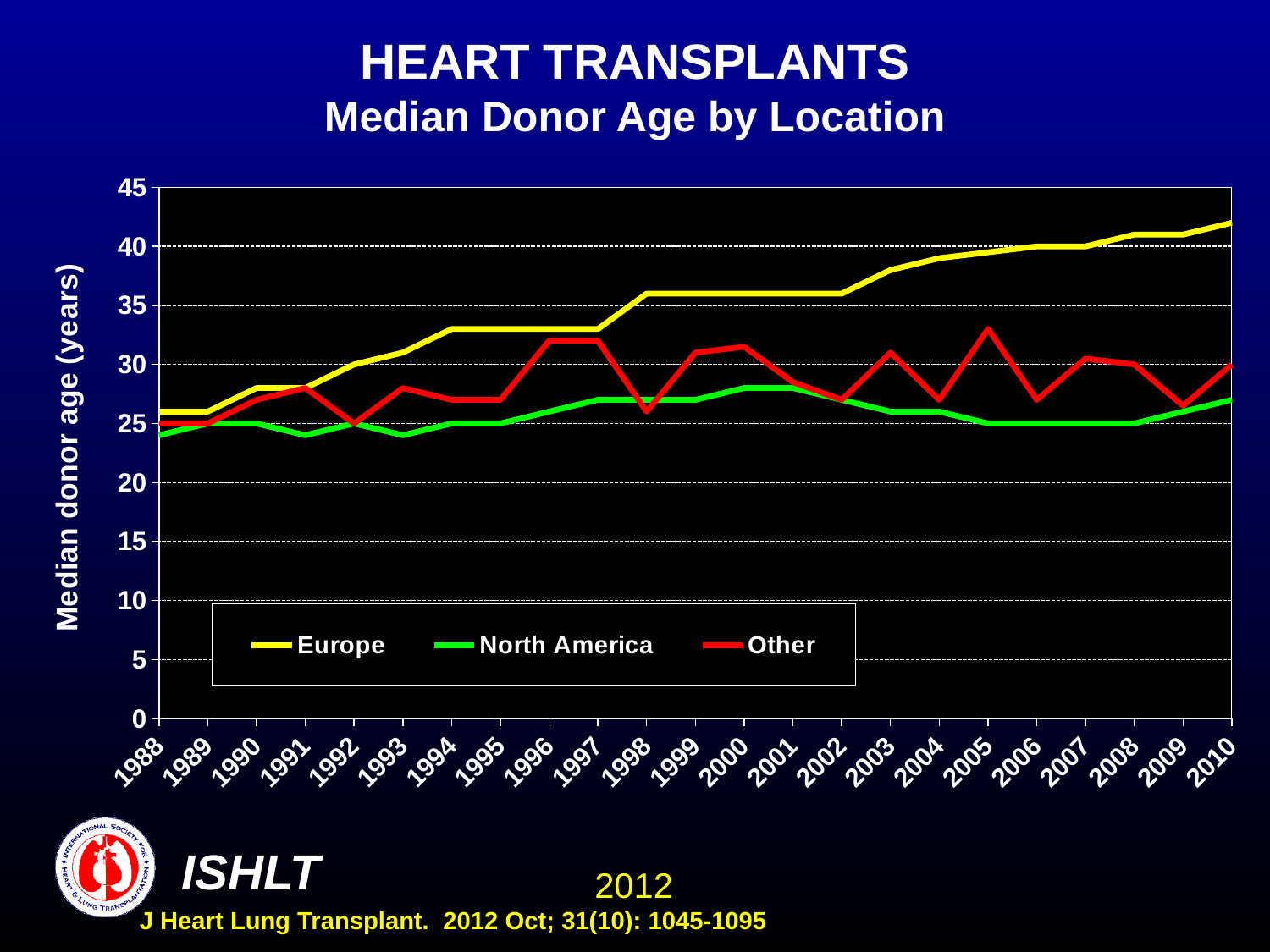
Is the median donor age for Other in 2005 greater or less than 30? greater Is the median donor age for Europe in 2010 greater or less than 40? greater In 2010, which is larger: the median donor age for Europe or for North America? Europe Does the median donor age for Europe generally rise or fall from 1988 to 2010? rise Which series has the highest median donor age in 2010? Europe What kind of chart is shown on the slide? line chart Is the median donor age for North America in 1988 greater or less than 25? less How many series does the legend list? 3 How many years are shown along the x axis? 23 What colour is the line for North America? green Which series has the lowest median donor age in 2005? North America